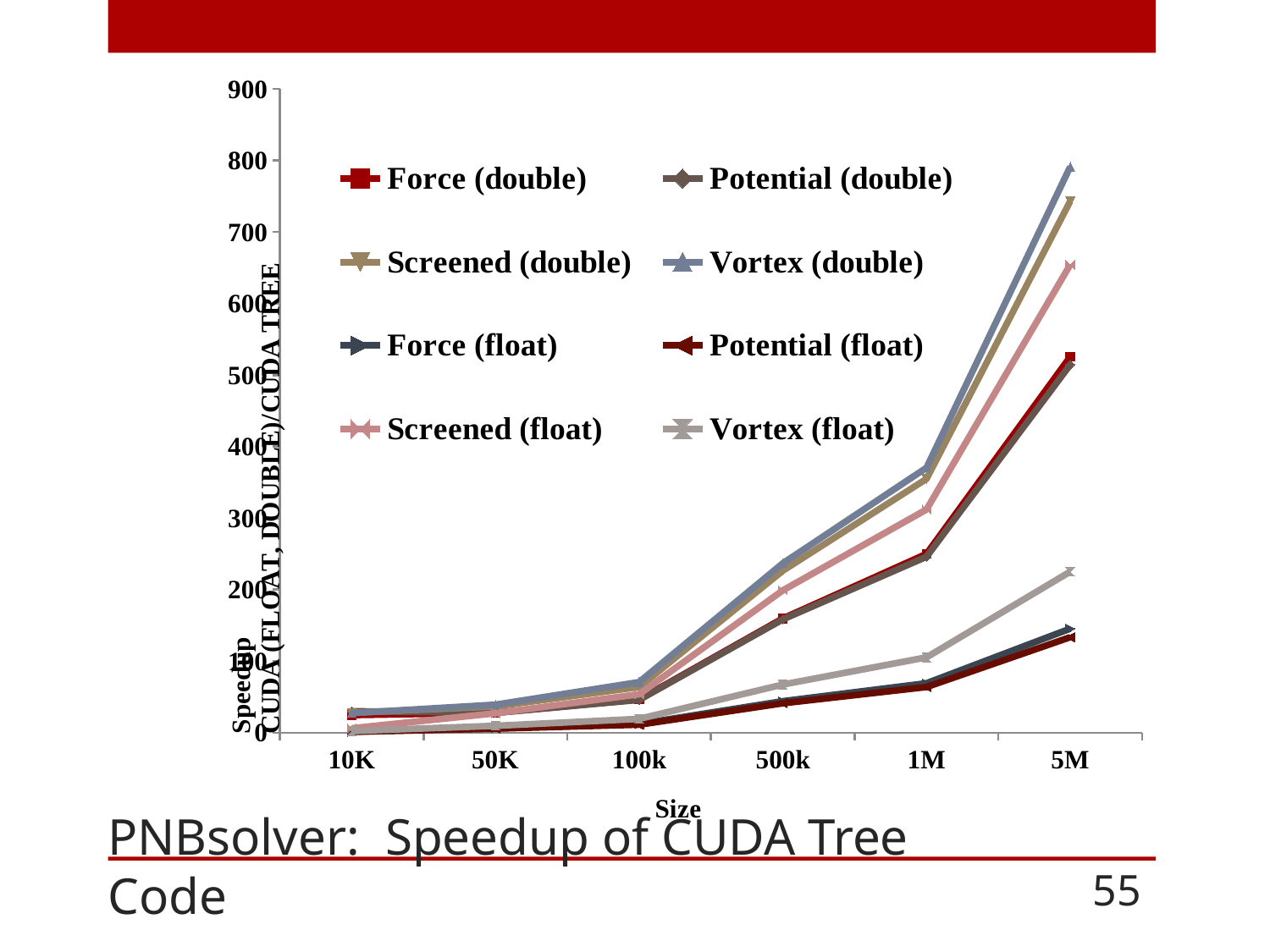
Do the speedup values rise or fall as the size increases from 10K to 5M? rise What kind of chart is shown on the slide? line chart Which is larger at 5M, Screened (float) or Force (double)? Screened (float) Is the value for Screened (float) at 5M greater or less than 600? greater Is the value for Vortex (float) at 5M greater or less than 200? greater Which is larger at 5M, Vortex (double) or Vortex (float)? Vortex (double) How many size categories are shown on the x axis? 6 Which series has the highest speedup at size 5M? Vortex (double) How many series does the legend list? 8 Is the value for Vortex (double) at 5M greater or less than 700? greater What is the title of the x axis? Size